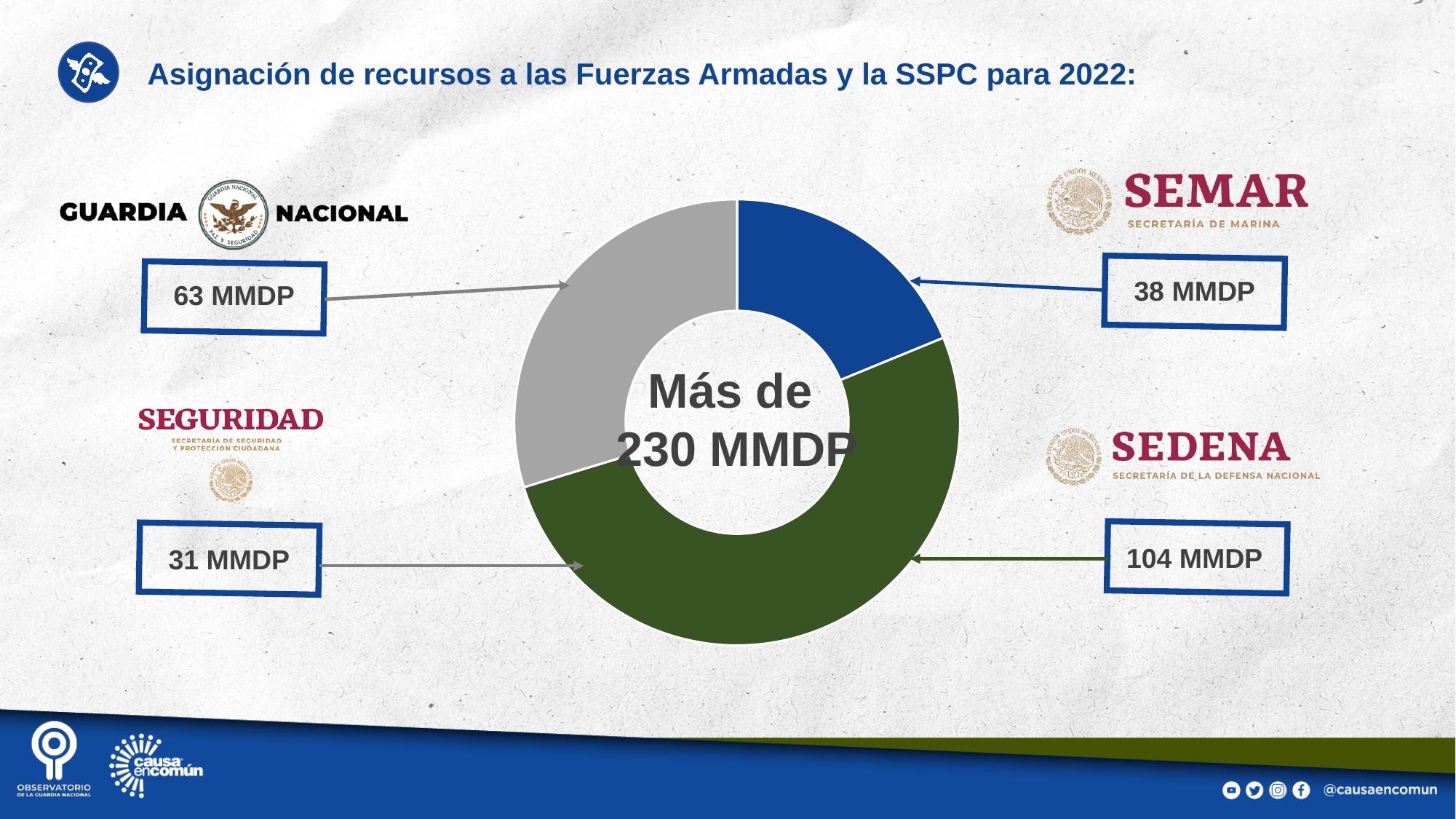
What is the value shown for Guardia Nacional? 63 MMDP What is the difference between the allocations for SEDENA and SEMAR? 66 MMDP Which institution receives the largest allocation? SEDENA How many institutions are shown with allocations on the chart? 4 Which institution receives the smallest allocation? Seguridad (SSPC) What is the value shown for SEMAR? 38 MMDP What text is written in the centre of the donut chart? Más de 230 MMDP What is the value shown for Seguridad (Secretaría de Seguridad y Protección Ciudadana)? 31 MMDP What is the difference between the allocations for Guardia Nacional and Seguridad? 32 MMDP Which receives more resources, Guardia Nacional or SEMAR? Guardia Nacional What kind of chart is shown on the slide? Donut (pie) chart What is the value shown for SEDENA? 104 MMDP